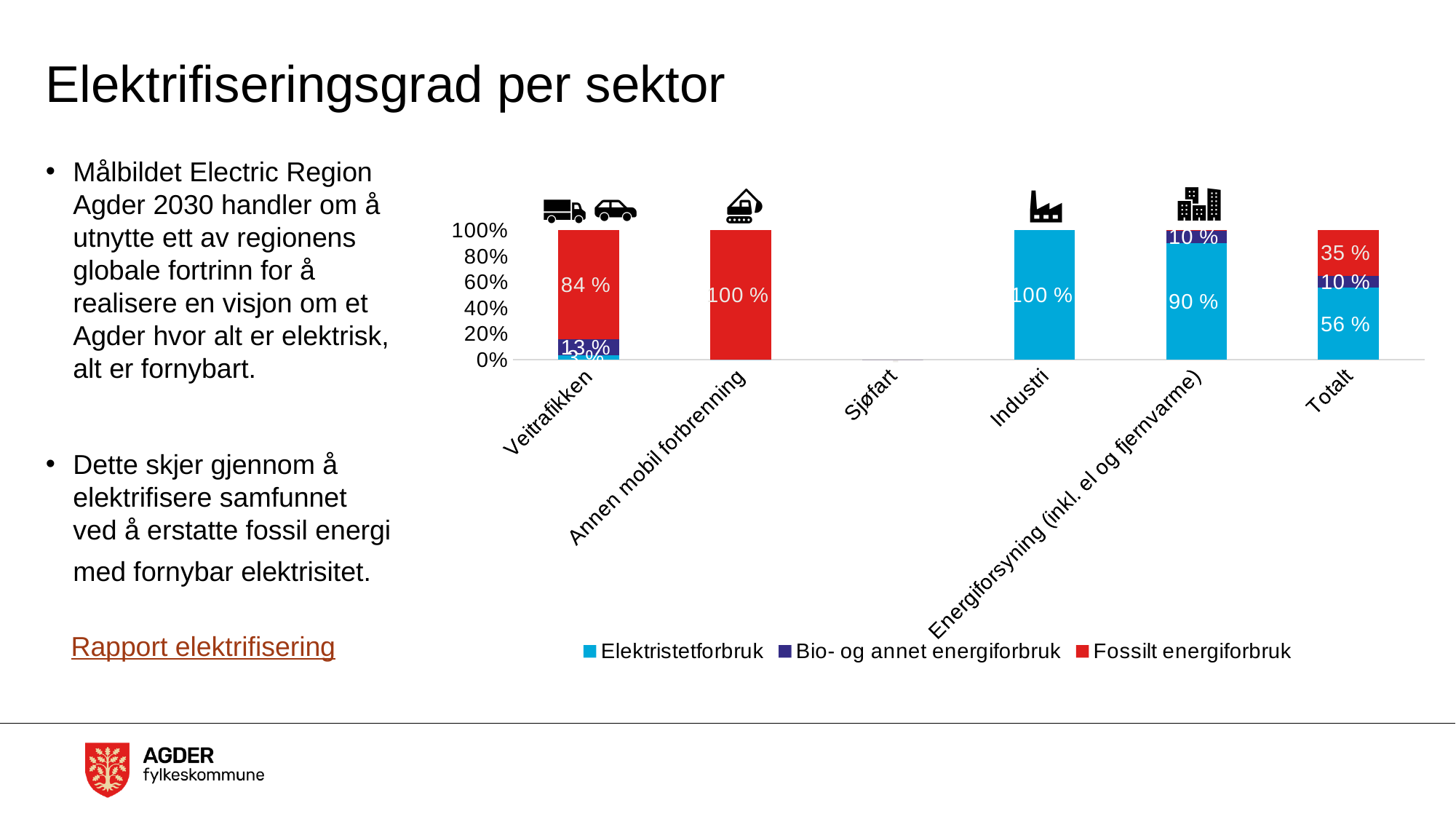
What is the Fossilt energiforbruk value for Veitrafikken? 84 % What is the difference between the Fossilt energiforbruk value for Veitrafikken and for Totalt? 49 % What is the Fossilt energiforbruk value for Totalt? 35 % Which is larger: the Elektristetforbruk value for Energiforsyning (inkl. el og fjernvarme) or for Totalt? Energiforsyning (inkl. el og fjernvarme) What kind of chart is shown on the slide? Stacked bar chart How many categories are shown on the x axis? 6 What is the Fossilt energiforbruk value for Annen mobil forbrenning? 100 % What is the Elektristetforbruk value for Energiforsyning (inkl. el og fjernvarme)? 90 % What is the Bio- og annet energiforbruk value for Veitrafikken? 13 % How many series does the legend list? 3 Which category has the highest Elektristetforbruk value? Industri What is the Elektristetforbruk value for Totalt? 56 %